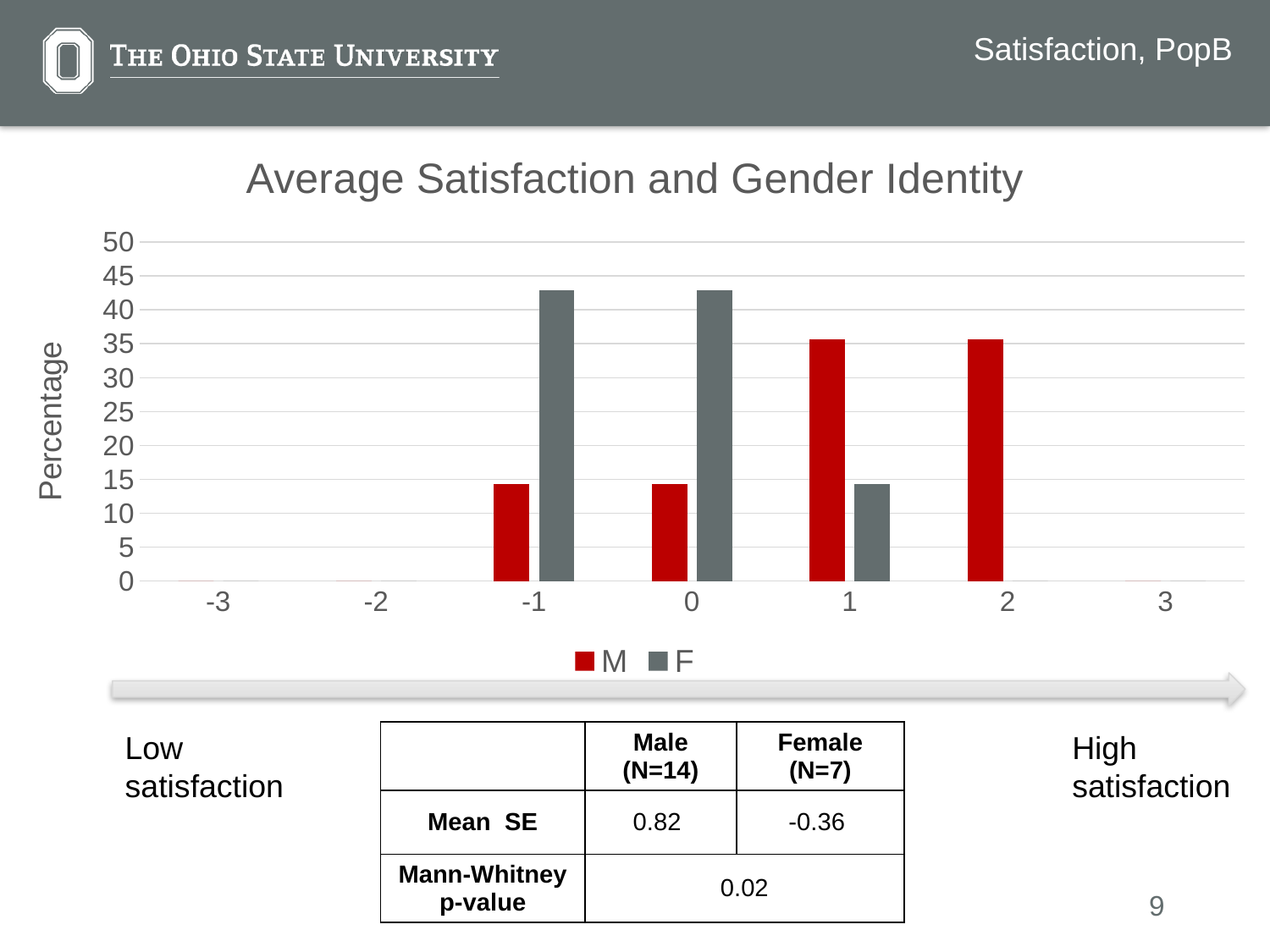
What is the title of the chart? Average Satisfaction and Gender Identity Is the value for M at category 1 greater or less than 30? greater At category 1, which series has the larger value, M or F? M What kind of chart is shown on the slide? bar chart What is the label on the y axis? Percentage At category 0, which series has the larger value, M or F? F At category -1, which series has the larger value, M or F? F How many series does the legend list? 2 How many categories are shown along the x axis? 7 Is the value for F at category -1 greater or less than 40? greater Is the value for F at category 1 greater or less than 20? less